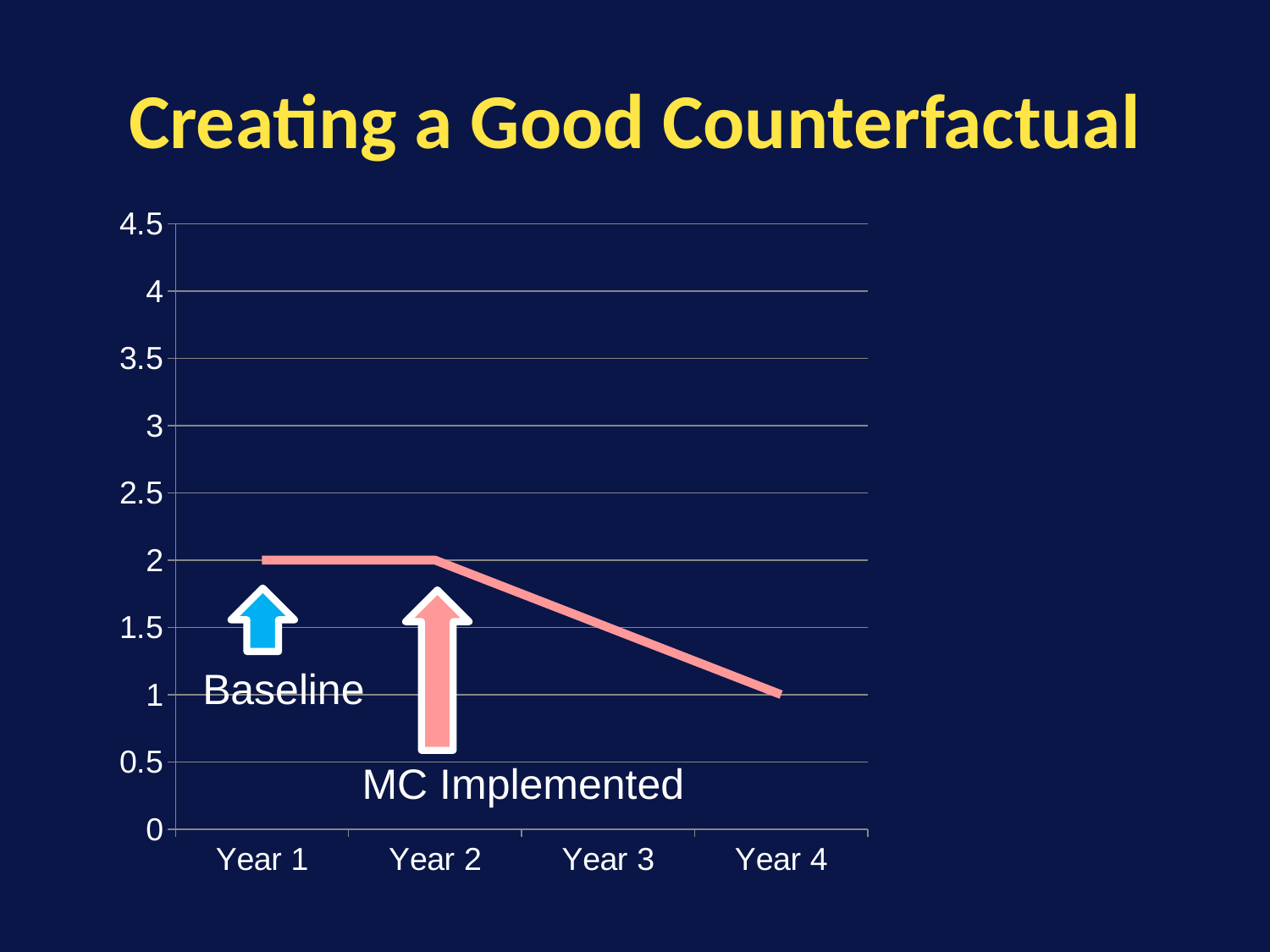
Do the values rise or fall from Year 2 to Year 4? Fall Which year has the lowest value? Year 4 Which is larger, the value for Year 1 or the value for Year 4? Year 1 What label is attached to the arrow pointing at Year 2? MC Implemented Is the value for Year 3 greater or less than 1? greater What is the difference between the value for Year 2 and the value for Year 4? 1 What type of chart is shown on the slide? Line chart What is the value for Year 1? 2 What is the value for Year 4? 1 What is the value for Year 2? 2 Is the value for Year 3 greater or less than 2? less How many years are shown on the x axis? 4